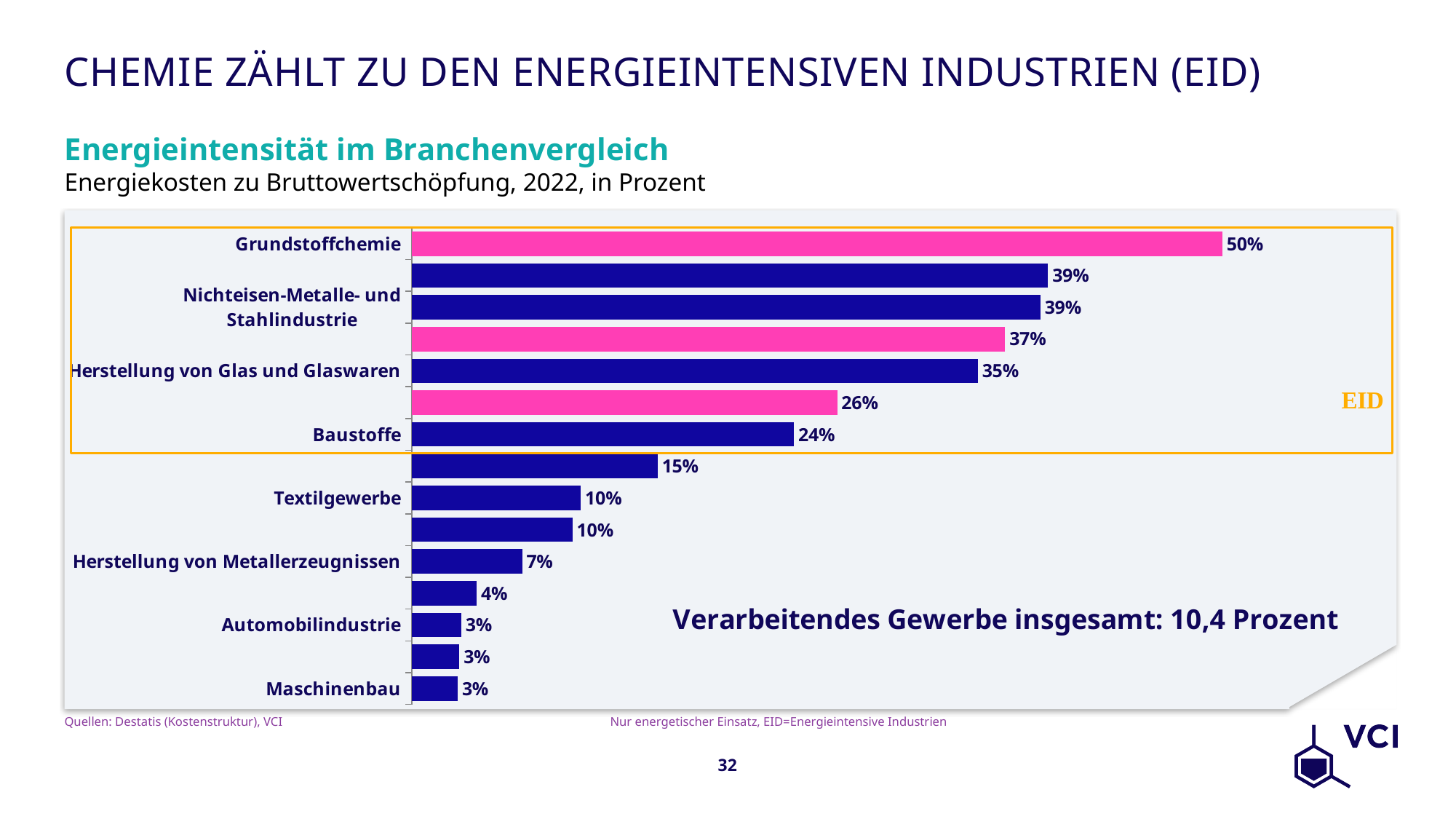
What is the difference between the values for Grundstoffchemie and Herstellung von Glas und Glaswaren? 15 percentage points What is the value for Baustoffe? 24% What value is given for Verarbeitendes Gewerbe insgesamt in the chart? 10,4 Prozent What is the value for Maschinenbau? 3% What is the value for Herstellung von Metallerzeugnissen? 7% What is the value for Textilgewerbe? 10% How many bars are plotted in the chart? 15 Which has the larger value, Baustoffe or Textilgewerbe? Baustoffe Which labelled industry has the highest value? Grundstoffchemie What kind of chart is shown? Bar chart What is the value for Herstellung von Glas und Glaswaren? 35% What is the value for Grundstoffchemie? 50%